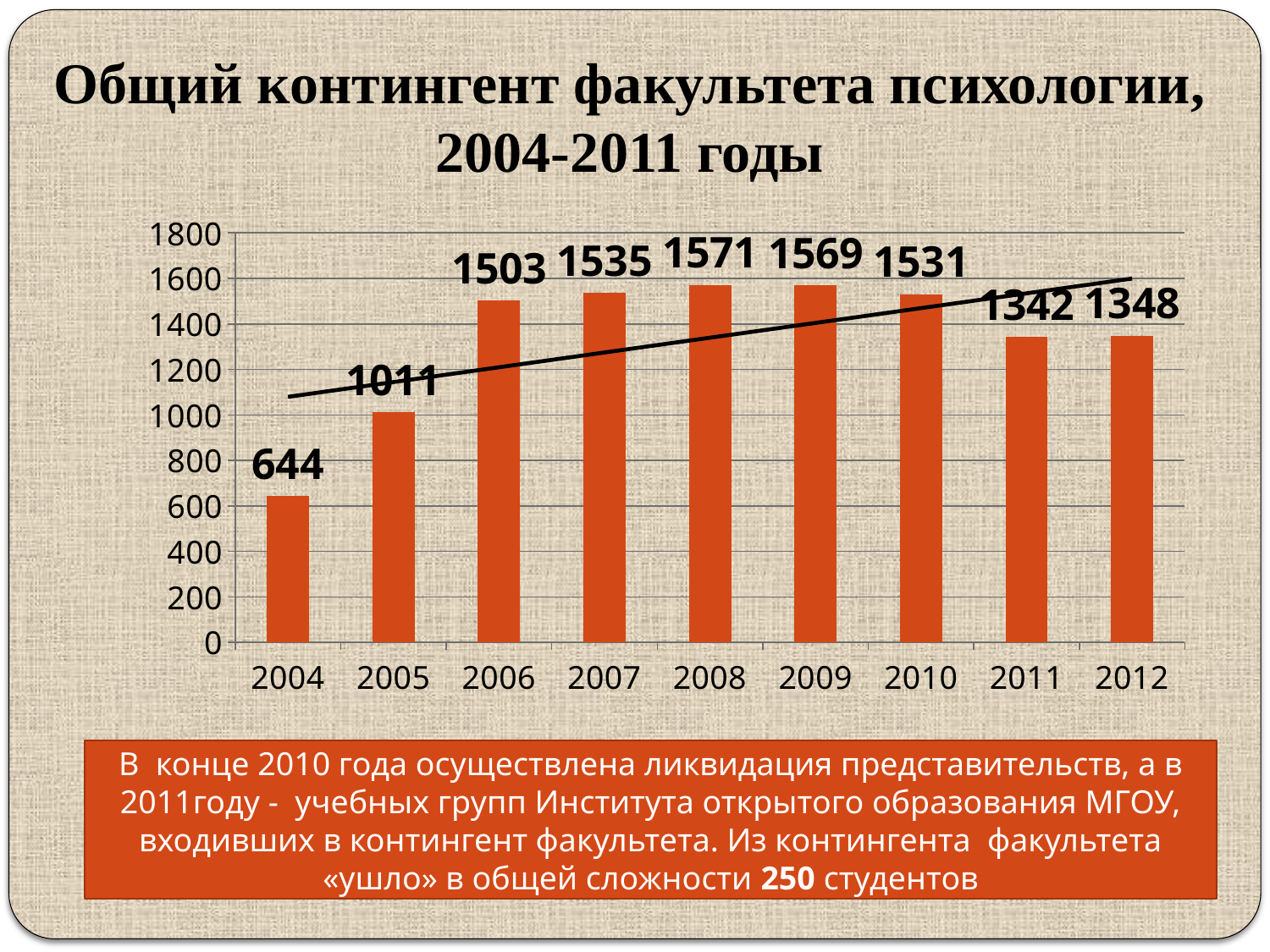
What is the difference between the values for 2010 and 2011? 189 How many years are shown on the x axis? 9 What is the title of the chart? Общий контингент факультета психологии, 2004-2011 годы Which year has the highest value? 2008 What is the value for 2004? 644 Is the value for 2007 greater or less than 1400? greater What kind of chart is shown on the slide? bar chart What is the value for 2008? 1571 What is the value for 2011? 1342 Which year has the lowest value? 2004 Which is larger, the value for 2006 or the value for 2012? 2006 What is the difference between the values for 2005 and 2004? 367